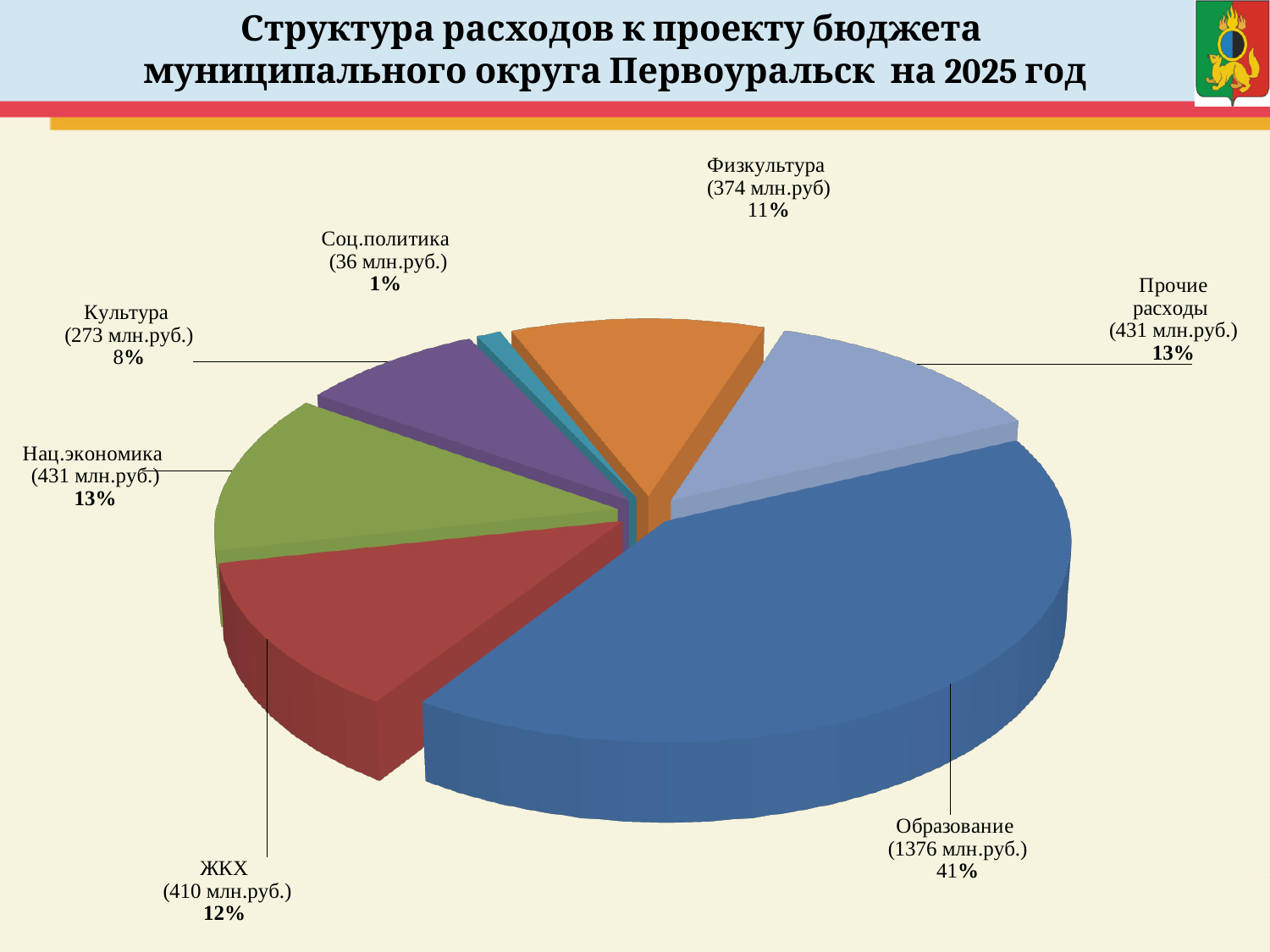
Which category has the largest slice? Образование What share of the pie does Физкультура take? 11% What is the value for Образование? 1376 млн.руб. Which category has the smallest slice? Соц.политика How many slices does the pie chart have? 7 What is the difference between the values for Образование and Прочие расходы? 945 млн.руб. What is the title of the slide? Структура расходов к проекту бюджета муниципального округа Первоуральск на 2025 год What share of the pie does Образование take? 41% What kind of chart is shown on the slide? pie chart What is the value for Соц.политика? 36 млн.руб. Which is larger, the value for Физкультура or the value for Культура? Физкультура What is the value for ЖКХ? 410 млн.руб.